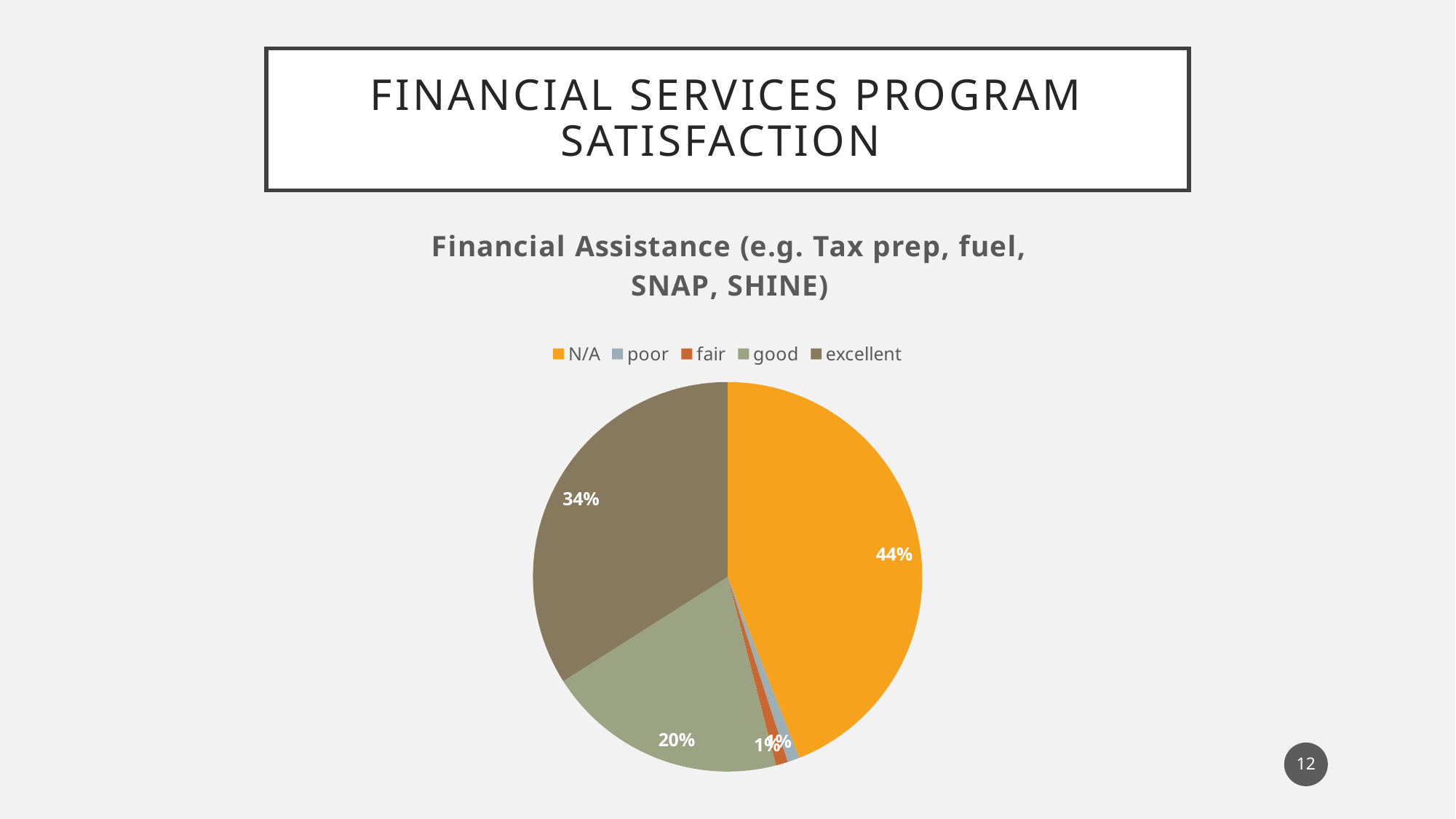
What type of chart is shown on the slide? Pie chart Which category has the largest slice of the pie chart? N/A What percentage of respondents rated the Financial Assistance program as good? 20% How many categories are shown in the pie chart? 5 What percentage of respondents rated the Financial Assistance program as excellent? 34% What is the difference in percentage points between the excellent slice and the good slice? 14% What colour is the N/A slice of the pie chart? Orange What percentage of the pie chart is labelled N/A? 44% What is the difference in percentage points between the N/A slice and the excellent slice? 10% What is the title of the chart? Financial Assistance (e.g. Tax prep, fuel, SNAP, SHINE) Which slice is larger, good or excellent? excellent How many entries does the legend list? 5